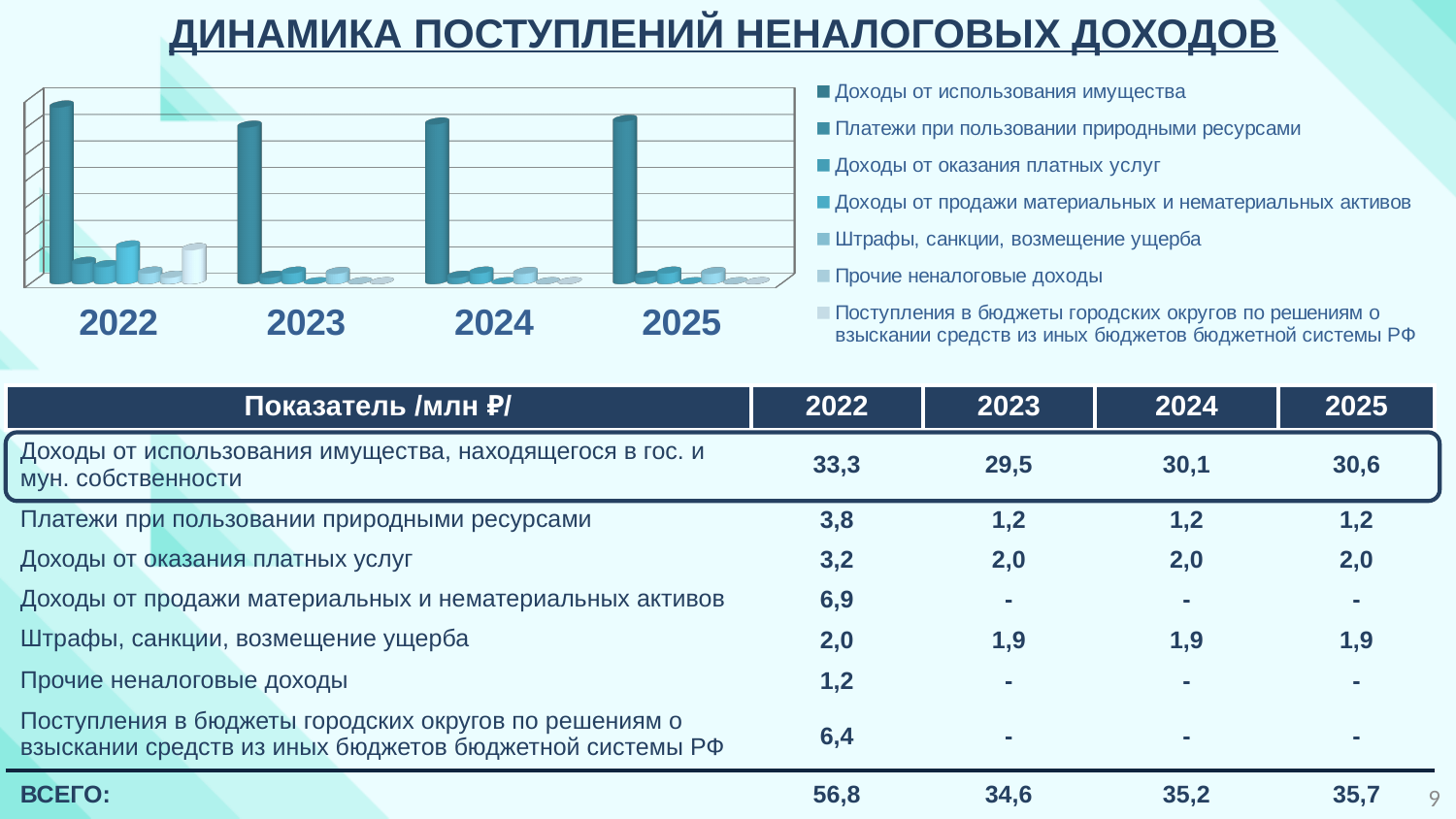
What is the value for 'Штрафы, санкции, возмещение ущерба' in 2025 (млн ₽)? 1,9 What is the total (ВСЕГО) of non-tax revenues for 2022 (млн ₽)? 56,8 Which year has the tallest bar for 'Доходы от использования имущества'? 2022 What is the difference between the 2022 and 2023 values for 'Доходы от использования имущества' (млн ₽)? 3,8 What is the value for 'Платежи при пользовании природными ресурсами' in 2022 (млн ₽)? 3,8 How many years (categories) are shown along the x axis of the chart? 4 What kind of chart is shown on the slide? bar chart What is the title of the slide's chart section? ДИНАМИКА ПОСТУПЛЕНИЙ НЕНАЛОГОВЫХ ДОХОДОВ Which year has the lowest total (ВСЕГО) of non-tax revenues? 2023 Is the bar for 'Доходы от использования имущества' taller in 2022 or in 2023? 2022 What is the value for 'Доходы от использования имущества, находящегося в гос. и мун. собственности' in 2022 (млн ₽)? 33,3 How many series does the chart legend list? 7